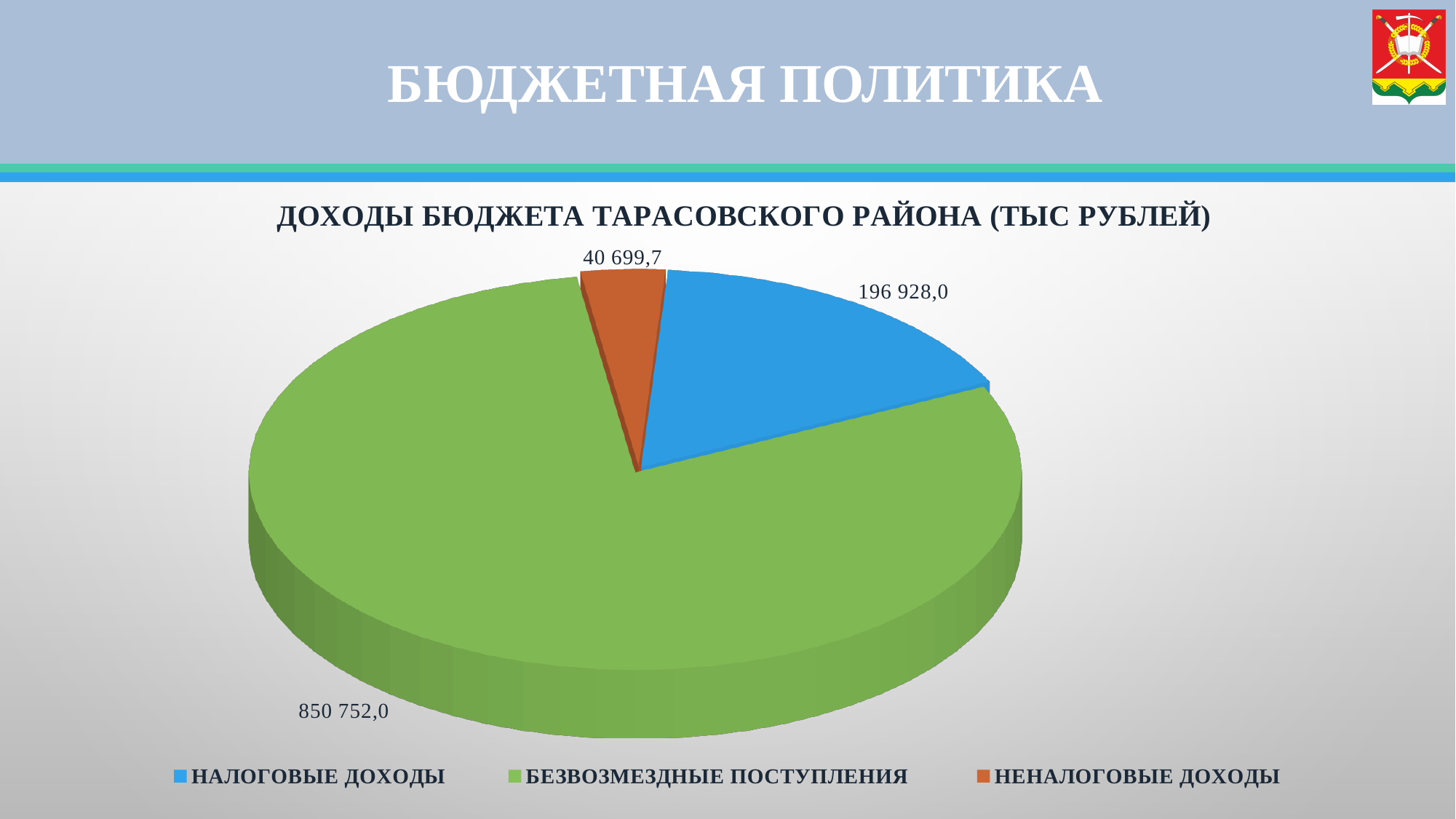
What is the difference between НАЛОГОВЫЕ ДОХОДЫ and НЕНАЛОГОВЫЕ ДОХОДЫ? 156 228,3 How many slices does the pie chart have? 3 Which category has the smallest slice of the pie? НЕНАЛОГОВЫЕ ДОХОДЫ What is the title of the chart? ДОХОДЫ БЮДЖЕТА ТАРАСОВСКОГО РАЙОНА (ТЫС РУБЛЕЙ) What is the total of all three slices? 1 088 379,7 What is the difference between БЕЗВОЗМЕЗДНЫЕ ПОСТУПЛЕНИЯ and НАЛОГОВЫЕ ДОХОДЫ? 653 824,0 Which is larger, НАЛОГОВЫЕ ДОХОДЫ or НЕНАЛОГОВЫЕ ДОХОДЫ? НАЛОГОВЫЕ ДОХОДЫ What is the value for НАЛОГОВЫЕ ДОХОДЫ? 196 928,0 What is the value for БЕЗВОЗМЕЗДНЫЕ ПОСТУПЛЕНИЯ? 850 752,0 What kind of chart is shown on the slide? Pie chart What is the value for НЕНАЛОГОВЫЕ ДОХОДЫ? 40 699,7 Which category has the largest slice of the pie? БЕЗВОЗМЕЗДНЫЕ ПОСТУПЛЕНИЯ